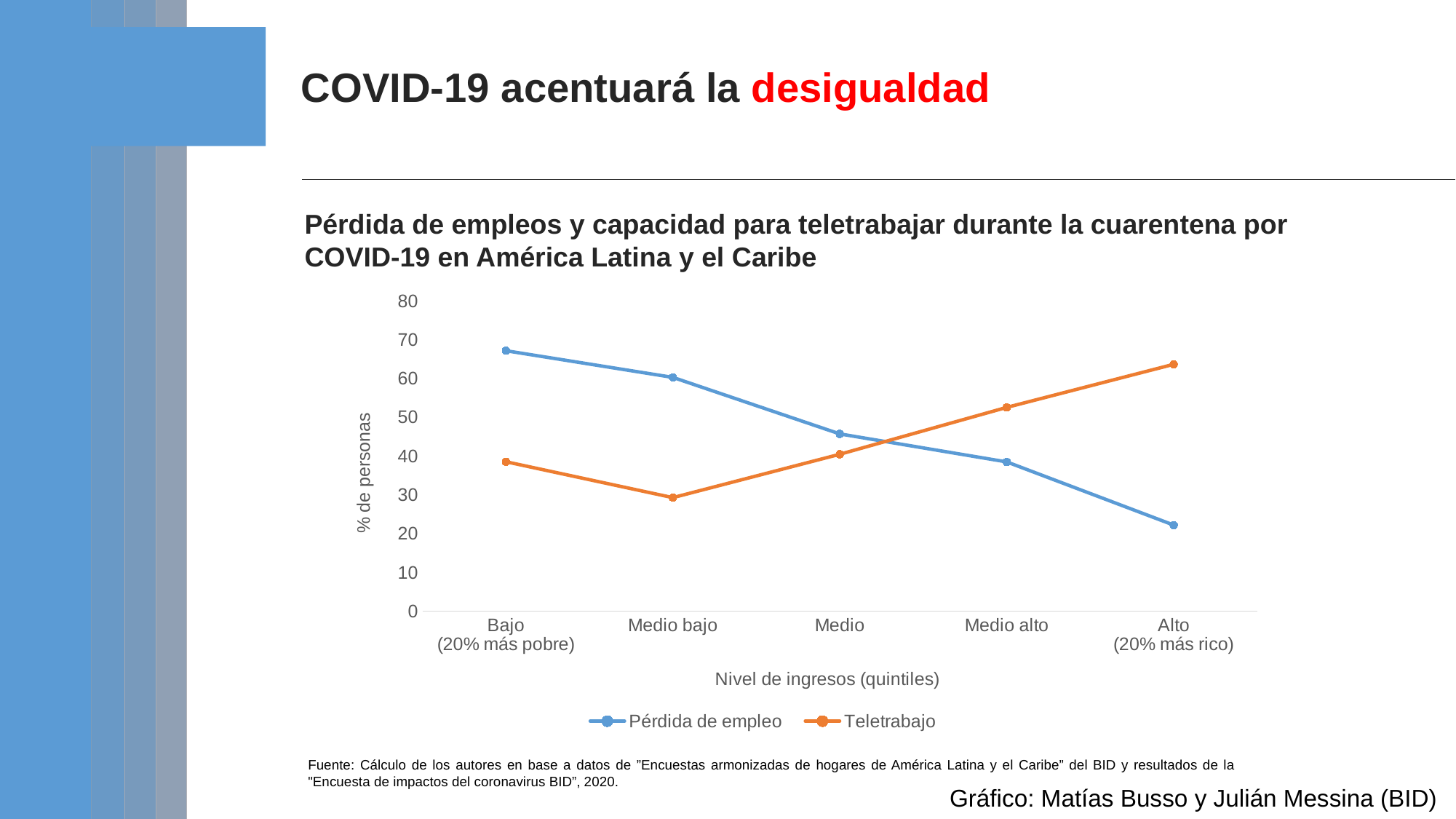
Is the value for Pérdida de empleo at Bajo (20% más pobre) greater or less than 60? greater Which income level has the lowest value for Teletrabajo? Medio bajo How many income quintile categories are shown on the x axis? 5 How many series does the legend list? 2 Does the Pérdida de empleo line rise or fall as income level increases from Bajo to Alto? fall Which income level has the lowest value for Pérdida de empleo? Alto (20% más rico) At Medio alto, which series has the larger value, Pérdida de empleo or Teletrabajo? Teletrabajo Which income level has the highest value for Teletrabajo? Alto (20% más rico) Which income level has the highest value for Pérdida de empleo? Bajo (20% más pobre) Is the value for Pérdida de empleo at Alto (20% más rico) greater or less than 30? less What kind of chart is shown on the slide? line chart